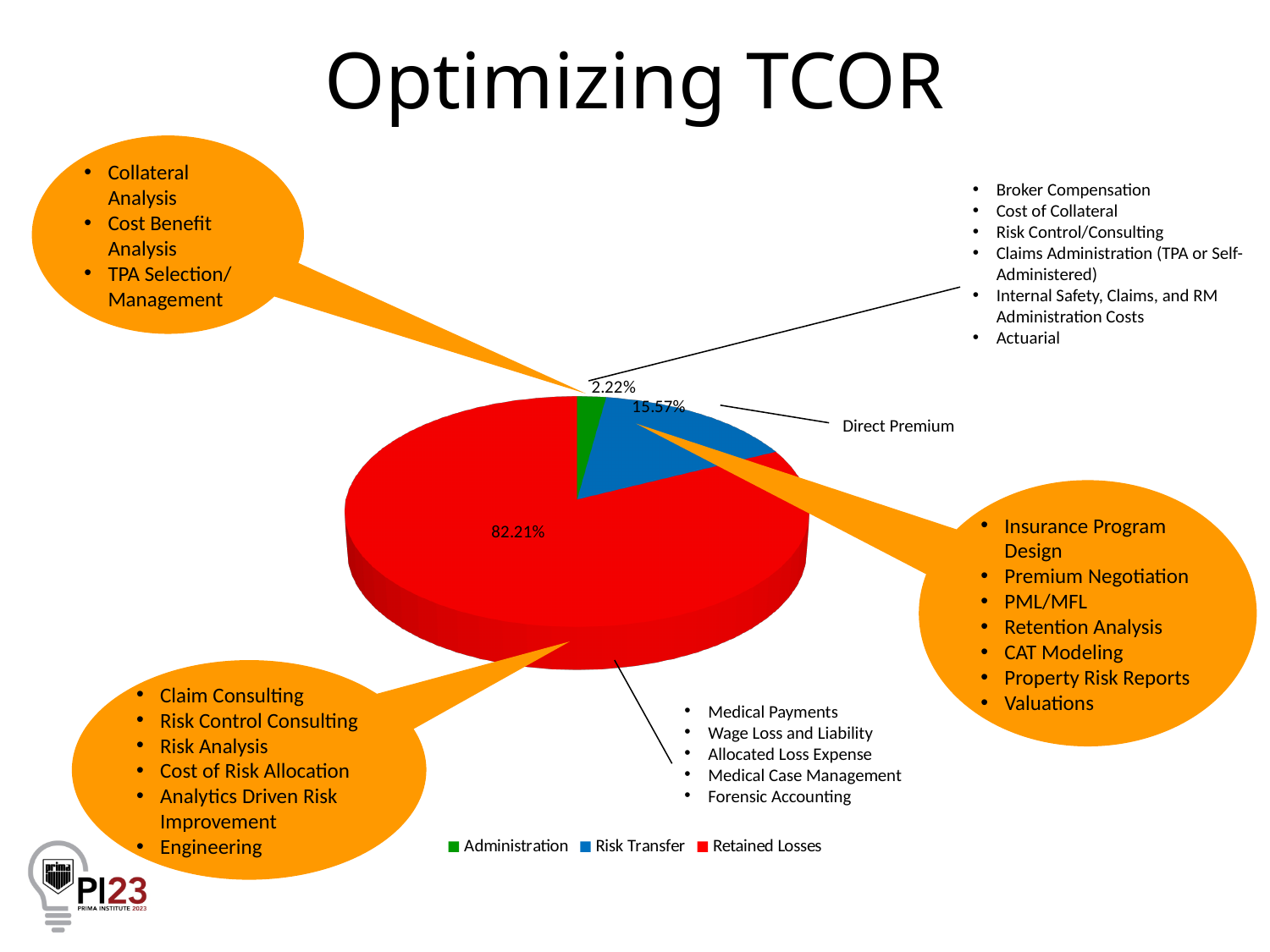
How many slices does the pie chart have? 3 What is the difference in percentage points between Retained Losses and Risk Transfer? 66.64 Which is larger, the Risk Transfer slice or the Administration slice? Risk Transfer What colour is the Retained Losses slice in the pie chart? red What share of the pie does Administration represent? 2.22% Which category has the smallest slice of the pie? Administration Which category has the largest slice of the pie? Retained Losses What kind of chart is shown on the slide? pie chart What share of the pie does Retained Losses represent? 82.21% What share of the pie does Risk Transfer represent? 15.57% How many entries does the chart legend list? 3 What is the difference in percentage points between Risk Transfer and Administration? 13.35